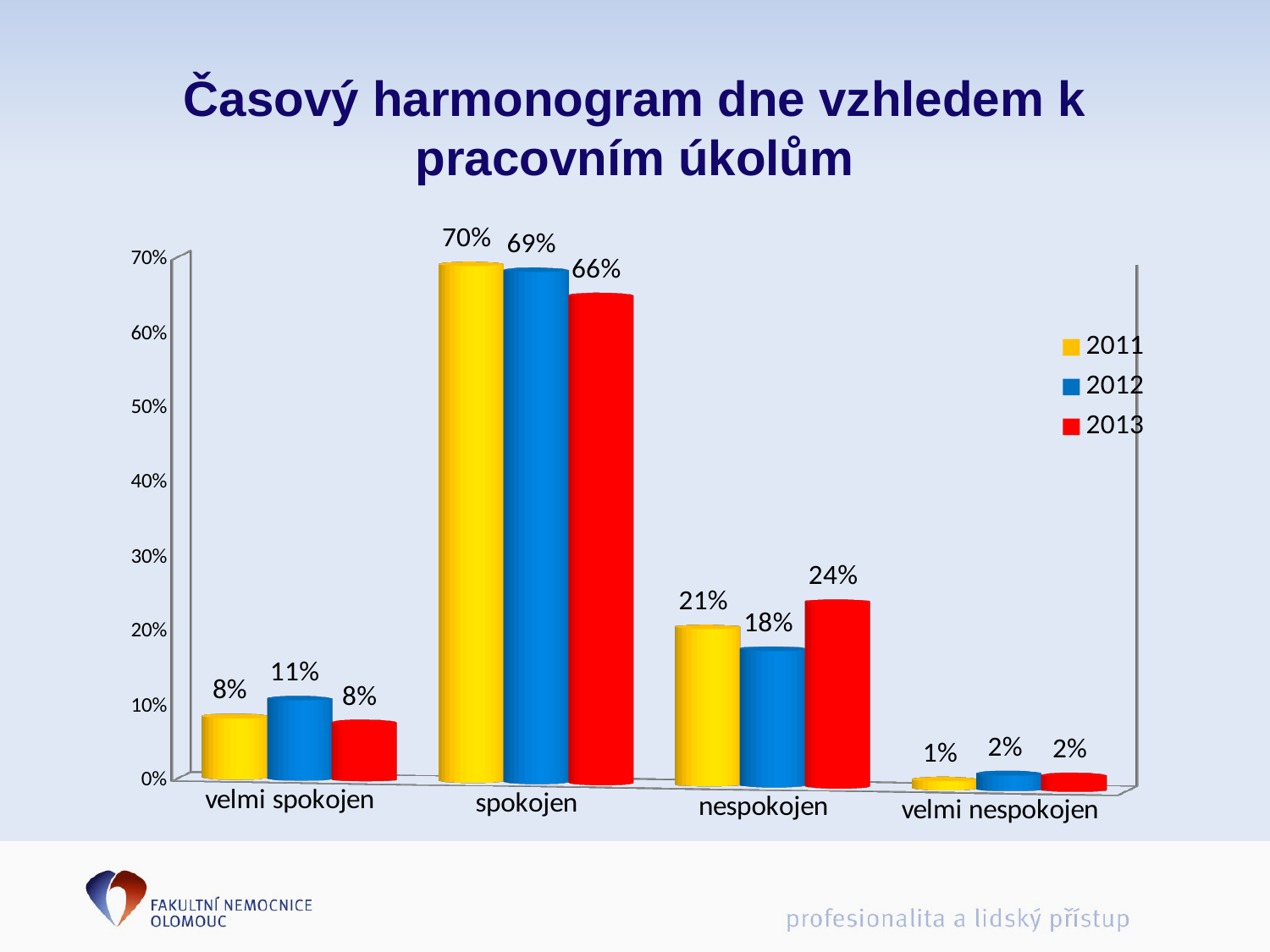
How many series does the legend list? 3 What kind of chart is shown on the slide? bar chart What is the value for 'nespokojen' in 2013? 24% What is the value for 'velmi spokojen' in 2012? 11% Which is larger for 'nespokojen': the 2011 value or the 2012 value? 2011 What is the value for 'velmi nespokojen' in 2011? 1% What is the value for 'spokojen' in 2011? 70% Which colour represents the 2013 series in the legend? red Which category has the highest value in 2013? spokojen What is the difference between the 2011 and 2013 values for 'spokojen'? 4% How many categories are shown on the x axis? 4 Which category has the lowest value in 2012? velmi nespokojen